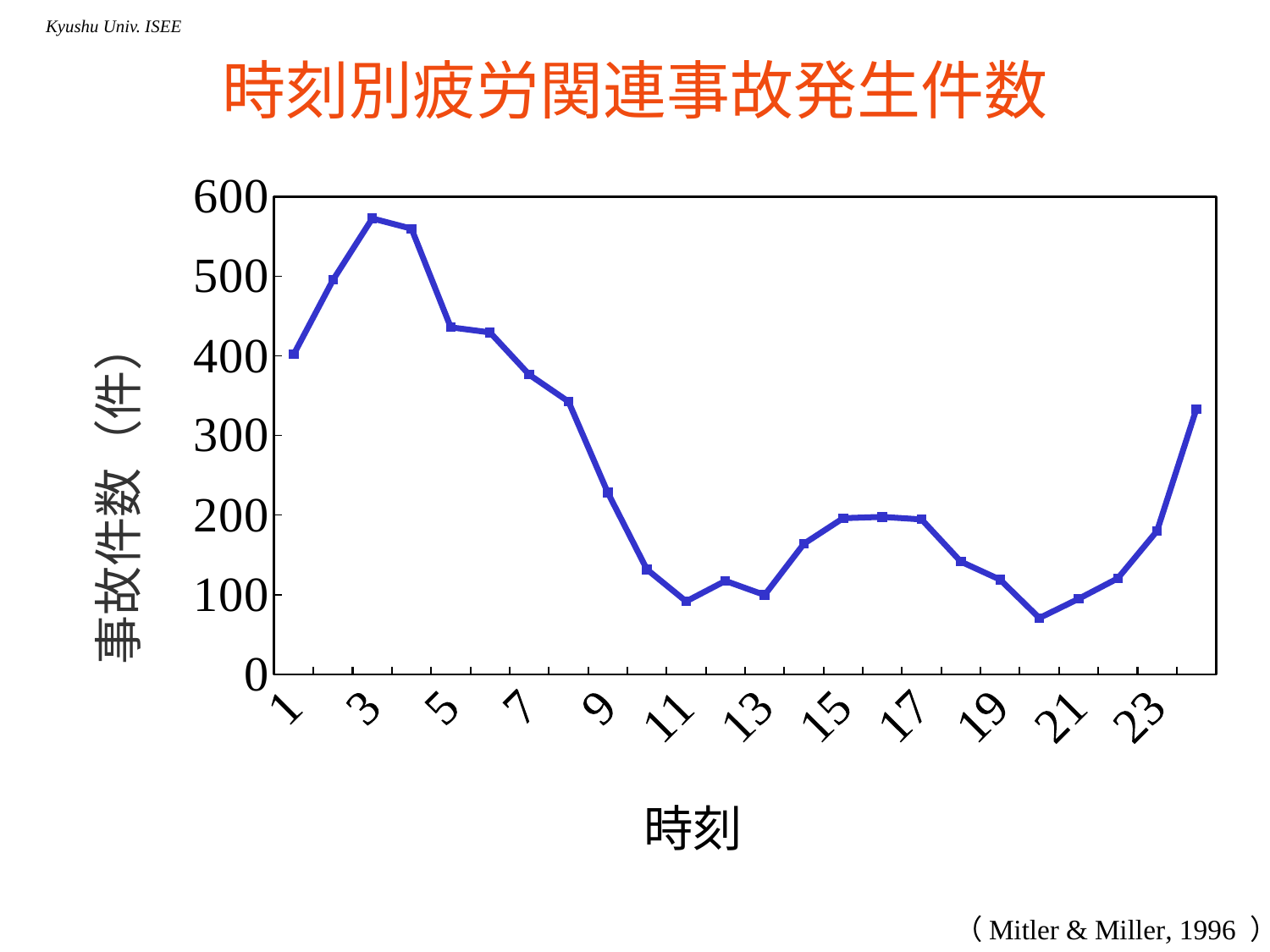
Is the value at hour 15 greater or less than 300? less Do the values rise or fall from hour 3 to hour 11? fall What kind of chart is shown on the slide? line chart At which hour (時刻) is the number of accidents lowest? 20 Is the value at hour 1 greater or less than 300? greater What is the title of the chart? 時刻別疲労関連事故発生件数 Is the value at hour 20 greater or less than 100? less Which has more accidents, hour 9 or hour 15? hour 9 What is the label of the y axis? 事故件数（件） Which has more accidents, hour 3 or hour 11? hour 3